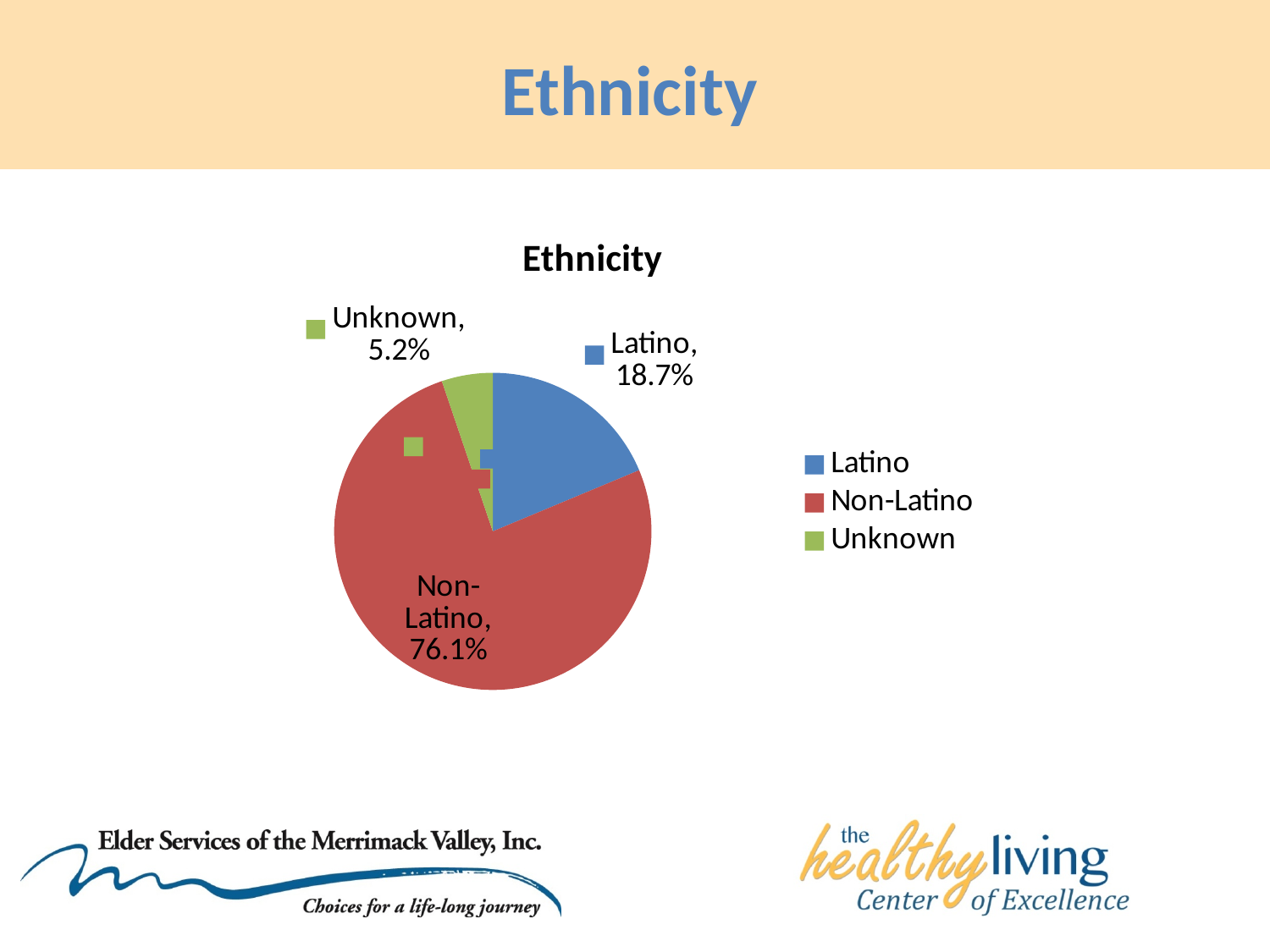
Which is larger, the Latino share or the Unknown share? Latino Which category has the largest share of the pie chart? Non-Latino How many categories are shown in the pie chart? 3 What is the difference in percentage points between Latino and Unknown? 13.5 What percentage of the pie chart is Unknown? 5.2% What percentage of the pie chart is Latino? 18.7% Which category has the smallest share of the pie chart? Unknown What percentage of the pie chart is Non-Latino? 76.1% What is the difference in percentage points between Non-Latino and Latino? 57.4 What kind of chart is shown on the slide? Pie chart What is the title of the chart? Ethnicity How many entries does the legend list? 3